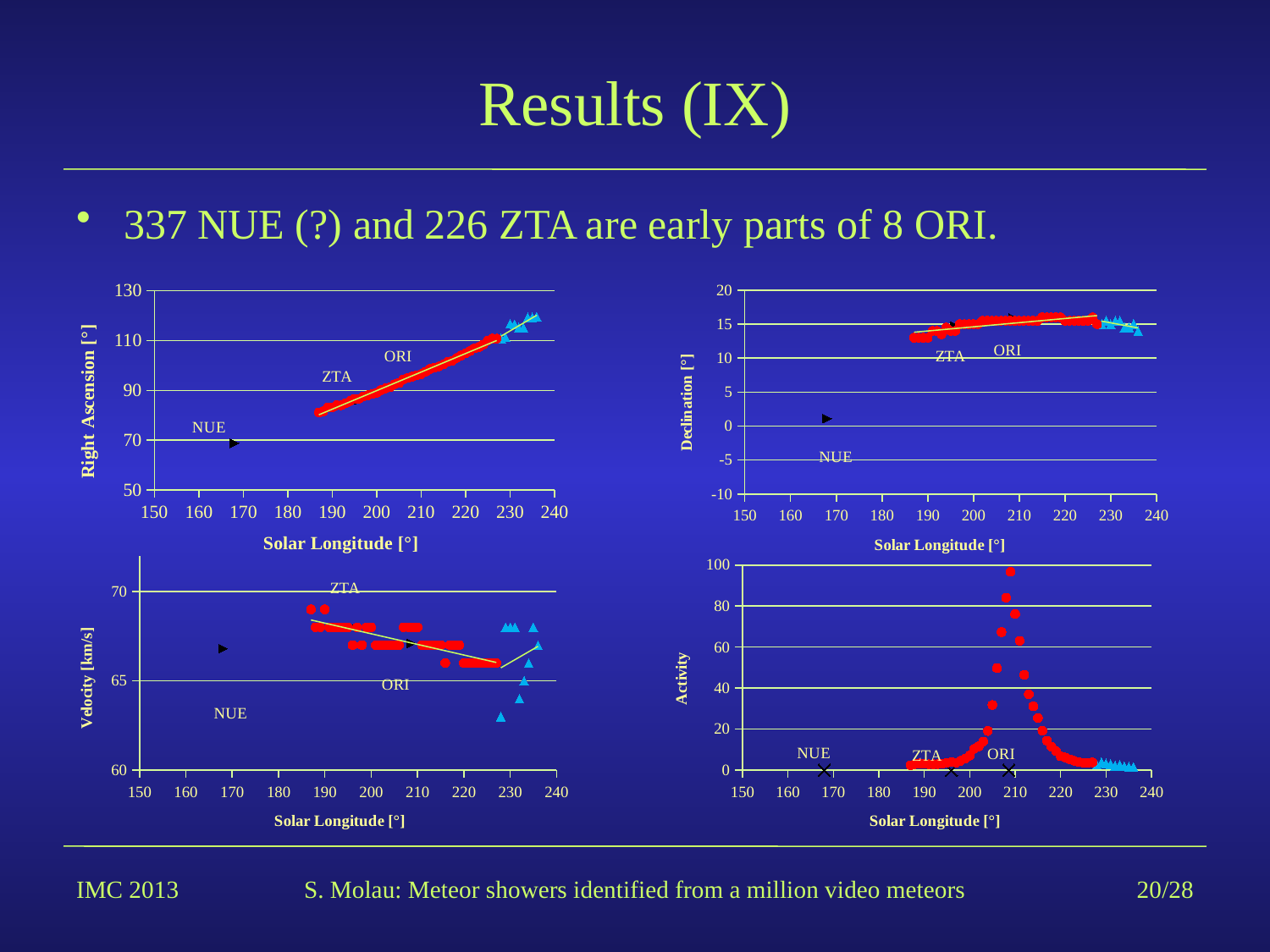
In the Right Ascension chart, is the value for NUE greater or less than 90? less In the Activity chart, which shower has the highest activity? ORI In the Velocity chart, do the red ZTA/ORI values rise or fall as solar longitude increases from 190 to 230? fall In the Activity chart, is the activity at solar longitude 230 greater or less than 20? less How many charts are shown on the slide? 4 In the Velocity chart, is the value for NUE greater or less than 65? greater In the Right Ascension chart, do the ORI values rise or fall as solar longitude increases? rise What is the x-axis label shared by all four charts? Solar Longitude [°] In the Right Ascension chart, which has the larger right ascension: the ORI points near solar longitude 230 or the NUE point? ORI points near 230 What kind of chart is the Right Ascension chart at the top left? scatter chart